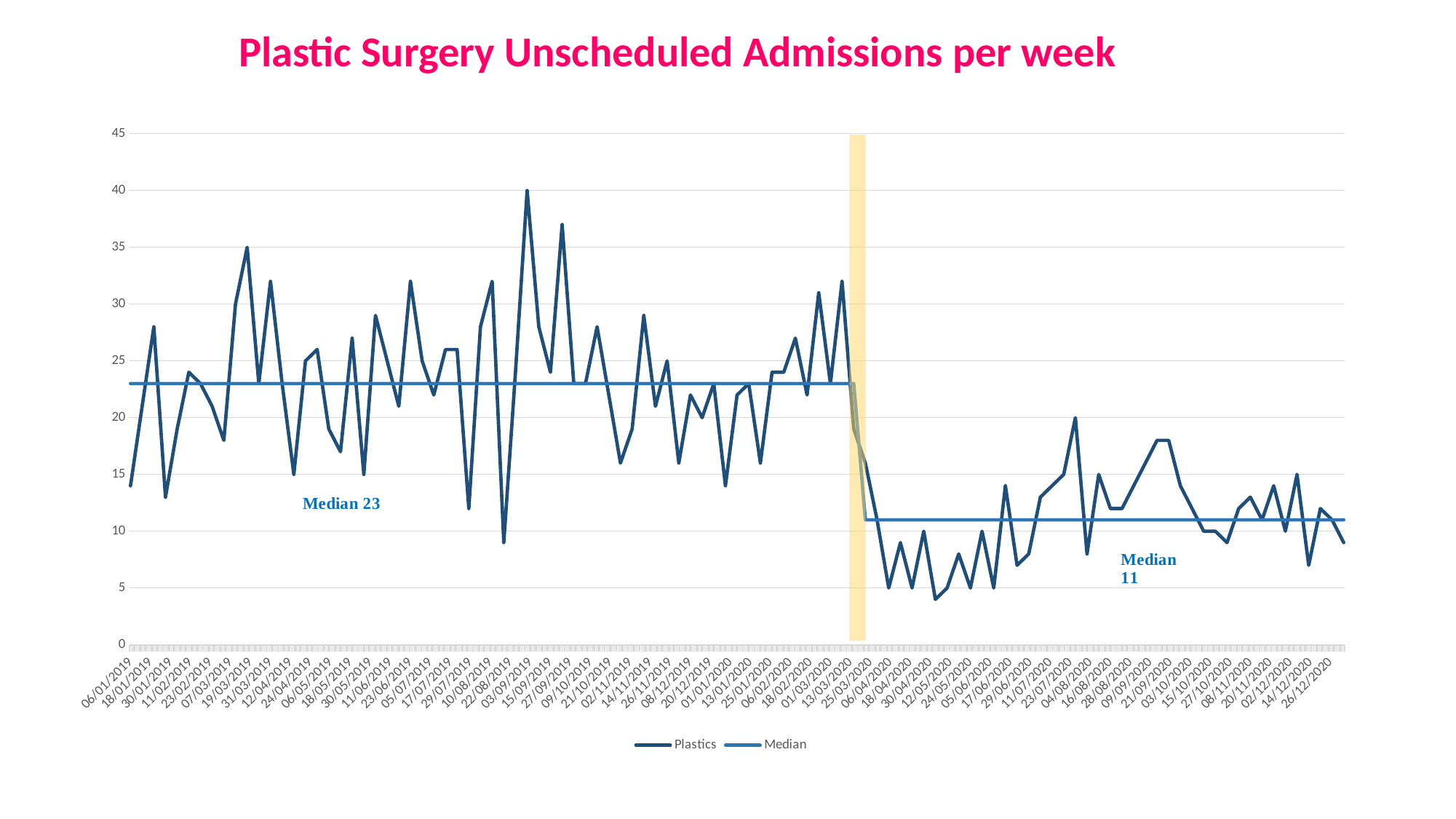
What is the median value annotated for the period after the shaded vertical band? 11 What is the median value annotated for the period before the shaded vertical band? 23 What is the title of the chart? Plastic Surgery Unscheduled Admissions per week How many series does the legend list? 2 Do the Plastics values generally rise or fall after the shaded vertical band in March 2020? fall By how much does the annotated median fall from the first period (Median 23) to the second period (Median 11)? 12 Which annotated median is larger, the one before the shaded band or the one after it? the one before the shaded band (23) What are the two series named in the legend? Plastics and Median What is the highest value reached by the Plastics line? 40 What kind of chart is shown on the slide? line chart Is the value for 06/01/2019 greater or less than 20? less Is the value for 26/12/2020 greater or less than 15? less